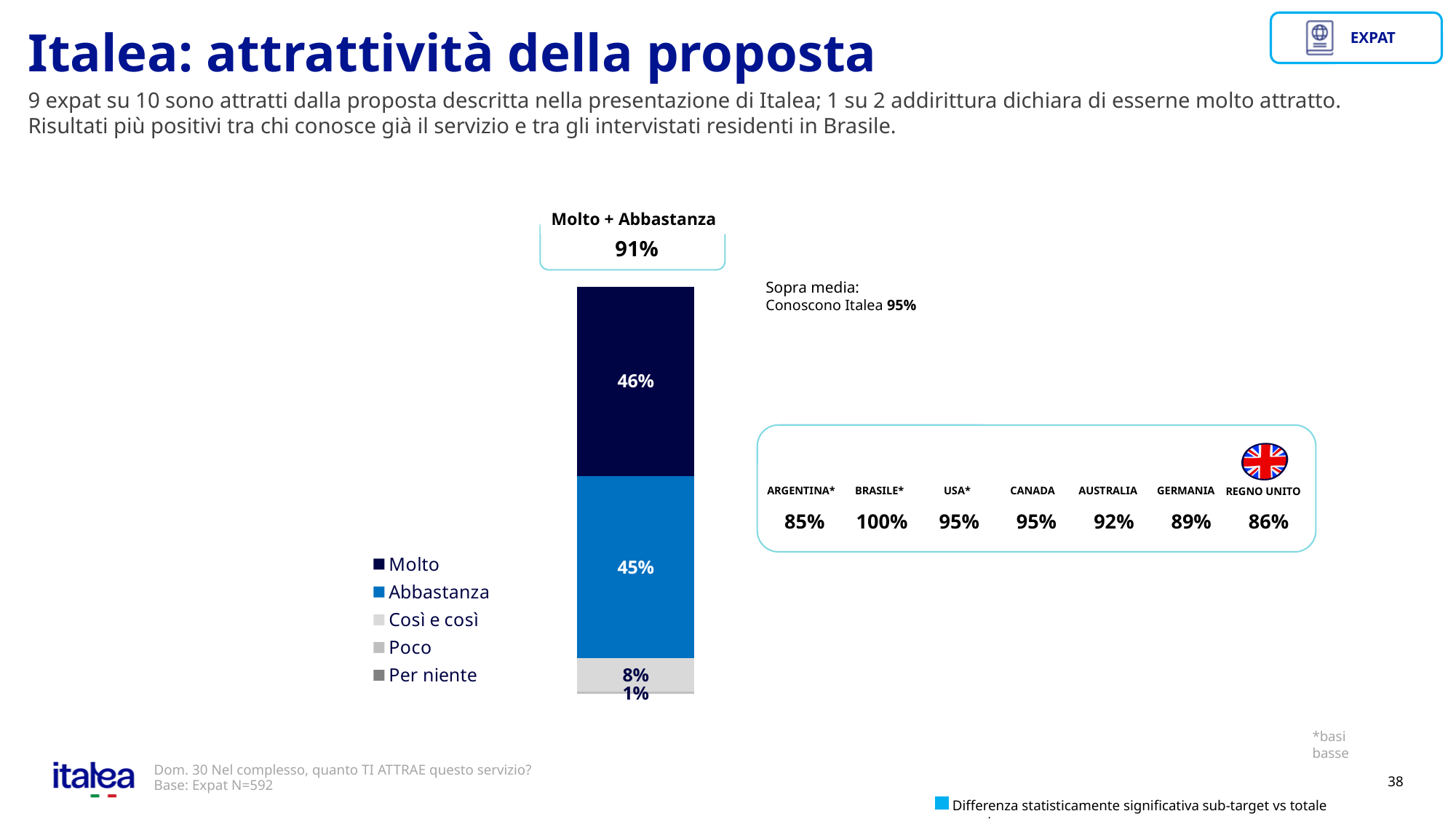
What percentage of expats answered "Molto" in the stacked bar chart? 46% How many response categories does the chart legend list? 5 What value is printed for the "Poco" segment at the bottom of the bar? 1% What is the difference between the "Molto" and "Così e così" percentages? 38% Which segment is larger, "Molto" or "Abbastanza"? Molto What is the value of the "Abbastanza" segment in the stacked bar? 45% What type of chart is used to show the attractiveness responses? Stacked bar chart What is the combined total of "Molto" and "Abbastanza" shown above the bar? 91% Which response category has the largest segment in the stacked bar? Molto By how many percentage points does "Abbastanza" exceed "Poco"? 44% What colour represents "Molto" in the chart legend? Dark navy blue What percentage is shown for the "Così e così" segment? 8%